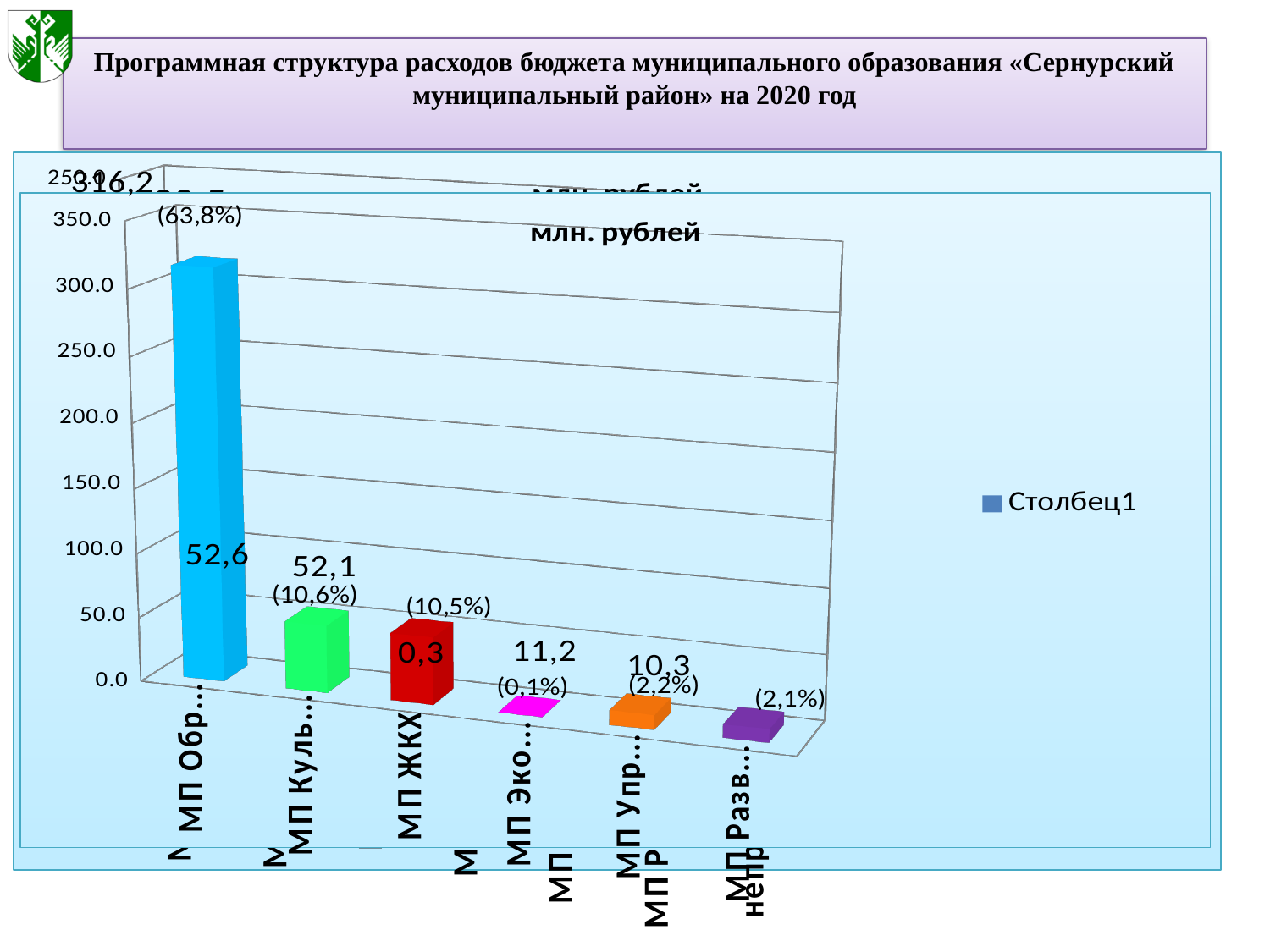
How many series does the chart legend list? 1 What kind of chart is shown on the slide? bar chart Is the value of the third (red) bar greater or less than 100? less What percentage share is printed above the tallest (blue) bar? 63,8% What is the legend entry shown to the right of the chart? Столбец1 Is the value of the first (blue) bar greater or less than 300? greater Which bar is the shortest in the chart? the fourth (magenta) bar, МП Эко... What unit is given in the chart title? млн. рублей Which bar is the tallest in the chart? the first (blue) bar, МП Обр... How many bars does the chart contain? 6 Which is larger: the second (green) bar or the fourth (magenta) bar? the second (green) bar Is the value of the second (green) bar greater or less than 100? less